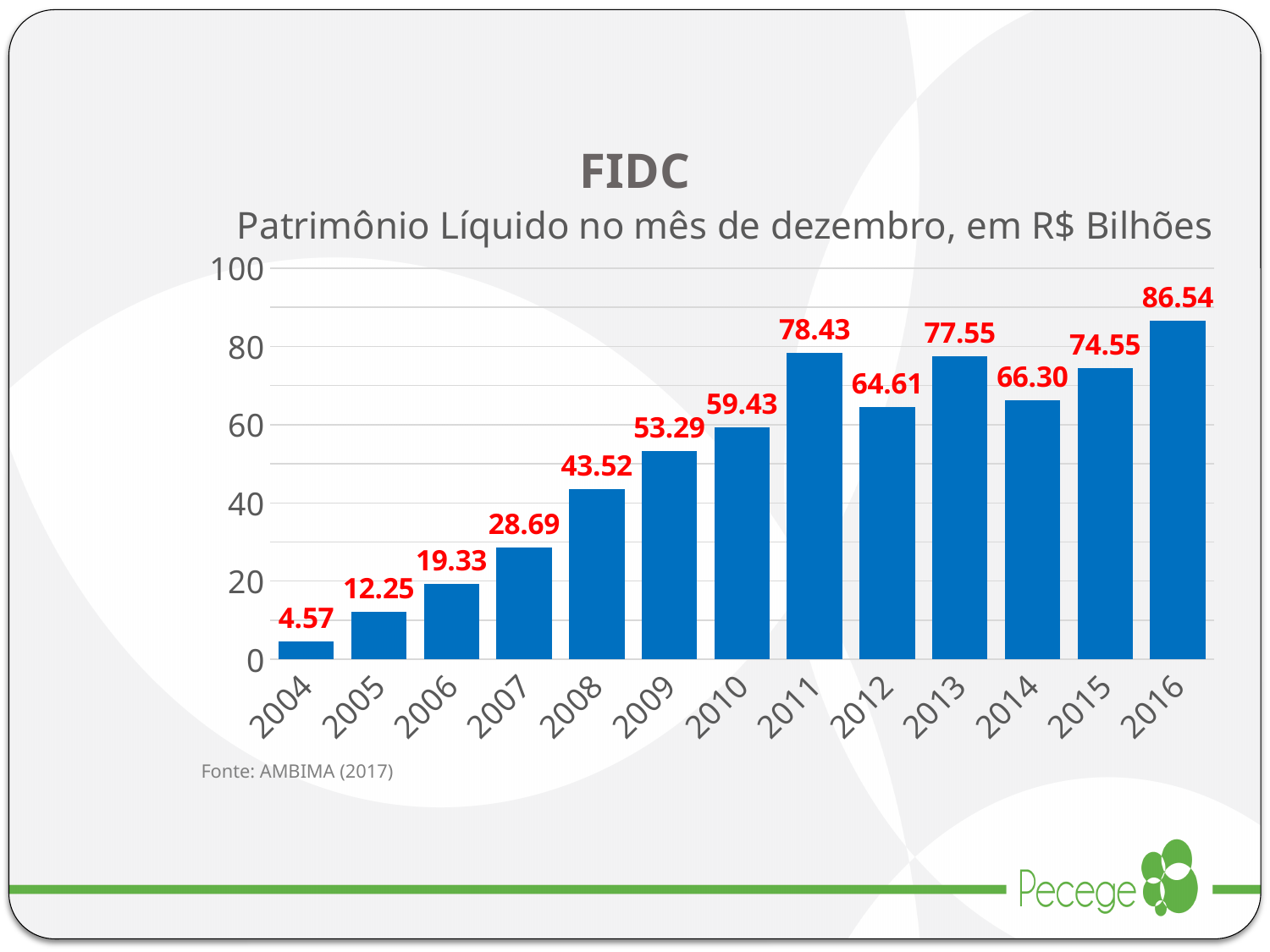
Which year has the highest value? 2016 What is the difference between the values for 2016 and 2015? 11.99 Which year has the lowest value? 2004 Do the values generally rise or fall from 2004 to 2011? rise What is the value for 2010? 59.43 What is the value for 2004? 4.57 How many years are shown on the x axis? 13 What is the source cited below the chart? AMBIMA (2017) What kind of chart is shown? bar chart What is the value for 2014? 66.30 Which is larger, the value for 2011 or the value for 2013? 2011 Is the value for 2012 greater or less than 60? greater